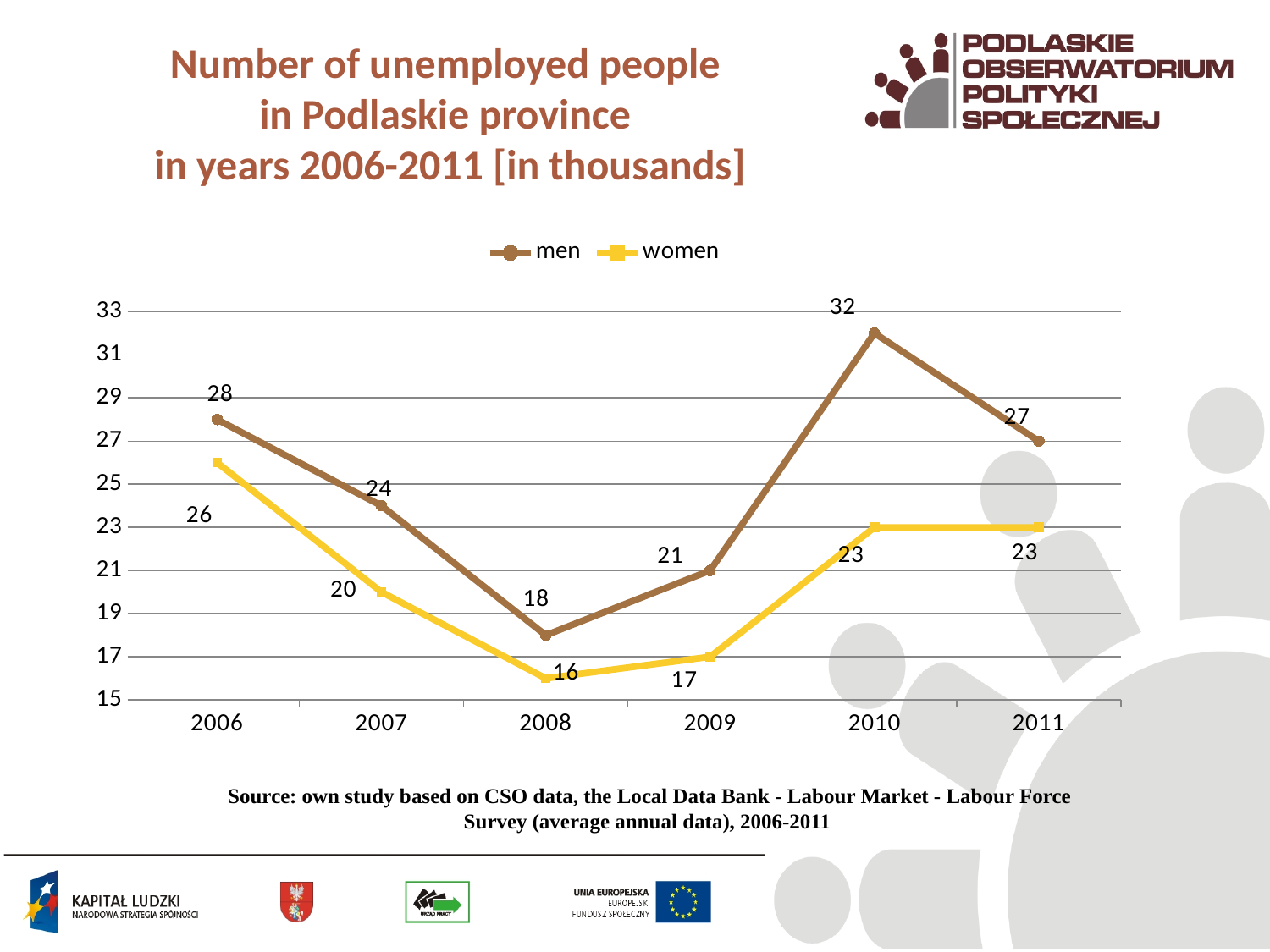
In which year is the value for men highest? 2010 What is the value for men in 2007? 24 What is the value for women in 2008? 16 Which is larger in 2006, the value for men or for women? men How many years are shown on the x axis? 6 Does the value for men rise or fall from 2006 to 2008? fall How many series does the legend list? 2 What is the value for men in 2010? 32 In which year is the value for women lowest? 2008 What kind of chart is shown on the slide? line chart What is the difference between the values for men and women in 2010? 9 Which colour is used for the women series? yellow